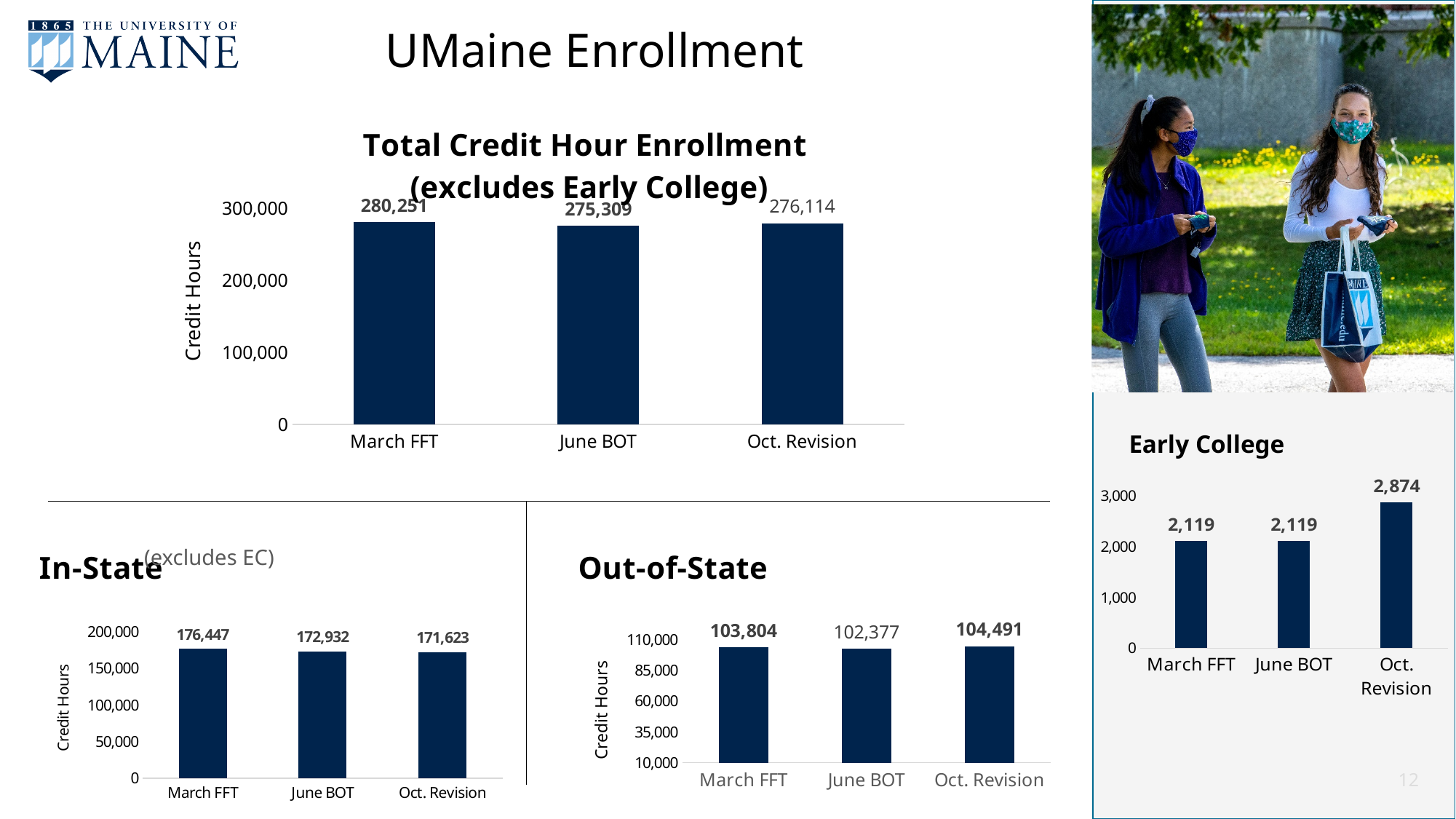
In the Early College chart, how many categories are shown? 3 In the In-State chart, do the values rise or fall from March FFT to Oct. Revision? fall What kind of chart is the Early College chart? bar chart In the Out-of-State chart, what is the value for Oct. Revision? 104,491 In the Out-of-State chart, what is the difference between Oct. Revision and June BOT? 2,114 In the In-State chart, which category has the highest value? March FFT In the Total Credit Hour Enrollment chart, what is the value for March FFT? 280,251 In the Early College chart, what is the value for Oct. Revision? 2,874 In the Out-of-State chart, which is larger, March FFT or June BOT? March FFT In the In-State chart, what is the value for June BOT? 172,932 In the Total Credit Hour Enrollment chart, what is the difference between March FFT and Oct. Revision? 4,137 In the Total Credit Hour Enrollment chart, which category has the lowest value? June BOT